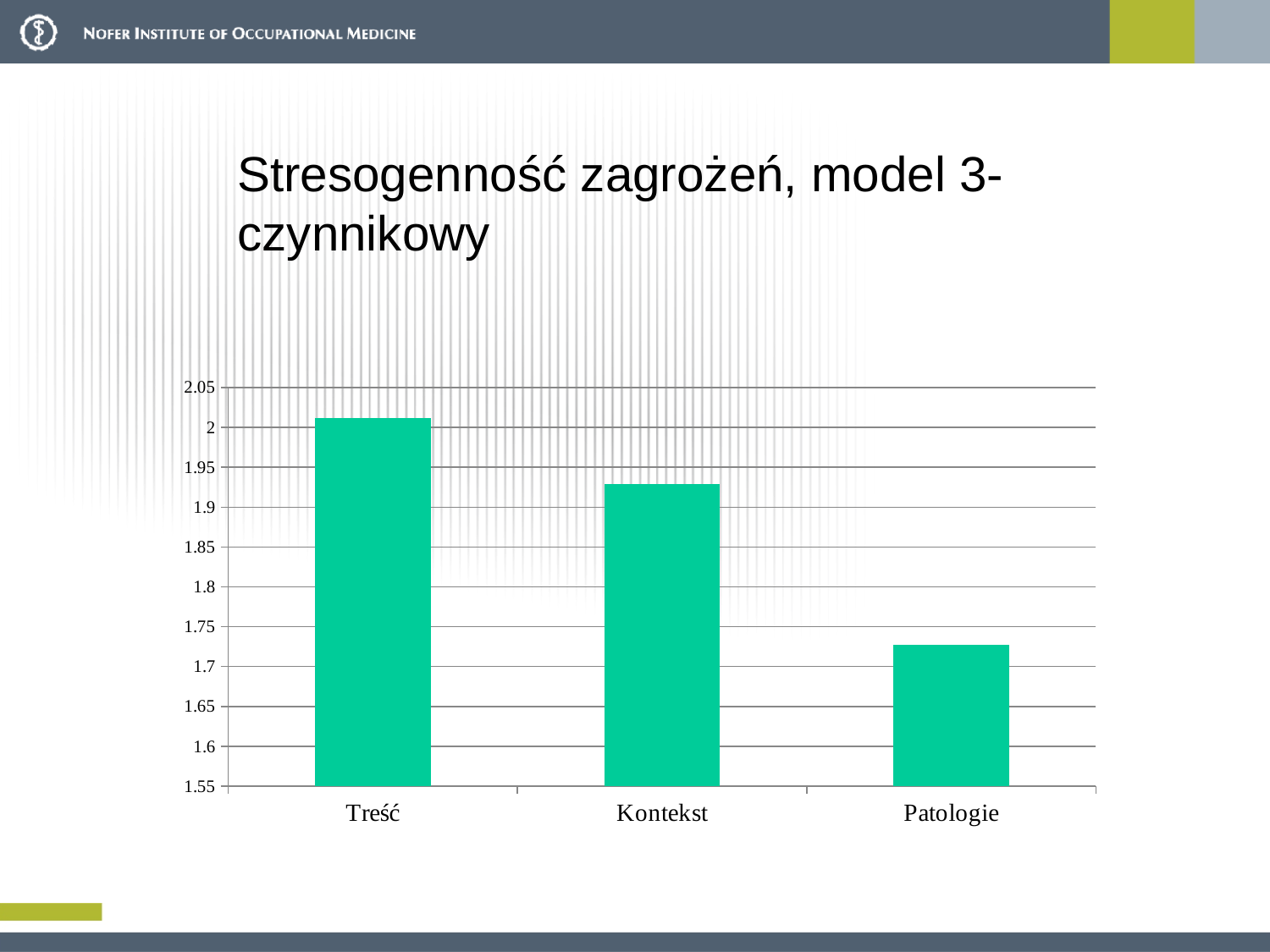
Which is larger, the value for Treść or the value for Kontekst? Treść What is the title of the slide containing the chart? Stresogenność zagrożeń, model 3-czynnikowy Which is larger, the value for Kontekst or the value for Patologie? Kontekst Is the value for Kontekst greater or less than 1.95? less Do the values rise or fall from left to right across the categories Treść, Kontekst and Patologie? fall Which category has the highest value in the chart? Treść Is the value for Patologie greater or less than 1.75? less Is the value for Treść greater or less than 1.95? greater Which category has the lowest value in the chart? Patologie What kind of chart is shown on the slide? bar chart How many categories are shown on the x axis of the chart? 3